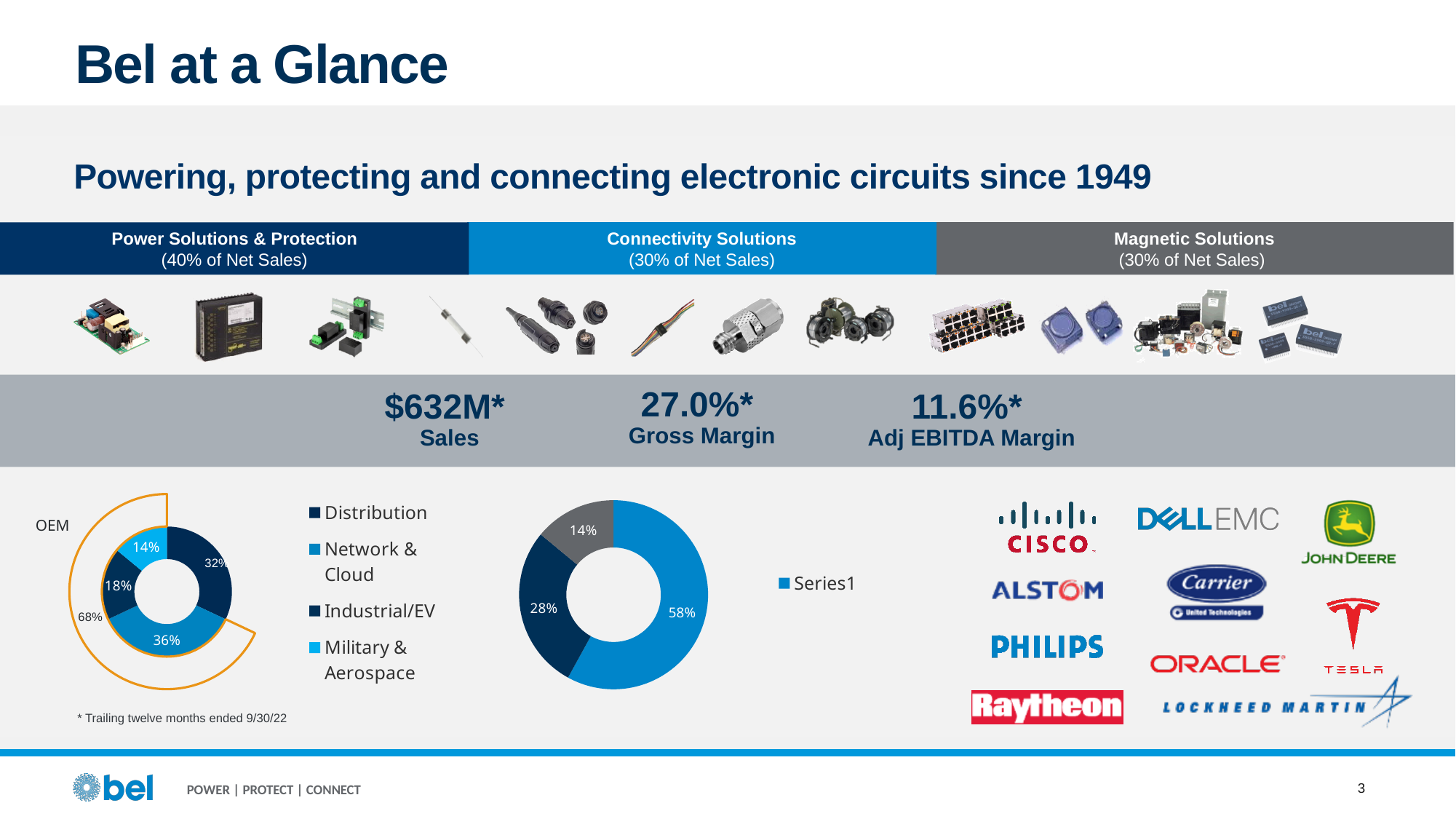
In the left donut chart, which is larger: Distribution or Industrial/EV? Distribution What type of chart is the right chart on the slide? Donut (pie) chart What percentage is labelled OEM next to the left donut chart? 68% How many categories does the legend of the left donut chart list? 4 In the right donut chart, what is the value of the largest slice? 58% In the left donut chart, what share is shown for Military & Aerospace? 14% In the left donut chart, what share is shown for Network & Cloud? 36% In the left donut chart, what is the difference between the Network & Cloud share and the Industrial/EV share? 18% In the left donut chart, which category has the largest share? Network & Cloud In the left donut chart, what share is shown for Industrial/EV? 18% In the left donut chart, which category has the smallest share? Military & Aerospace In the left donut chart, what share is shown for Distribution? 32%